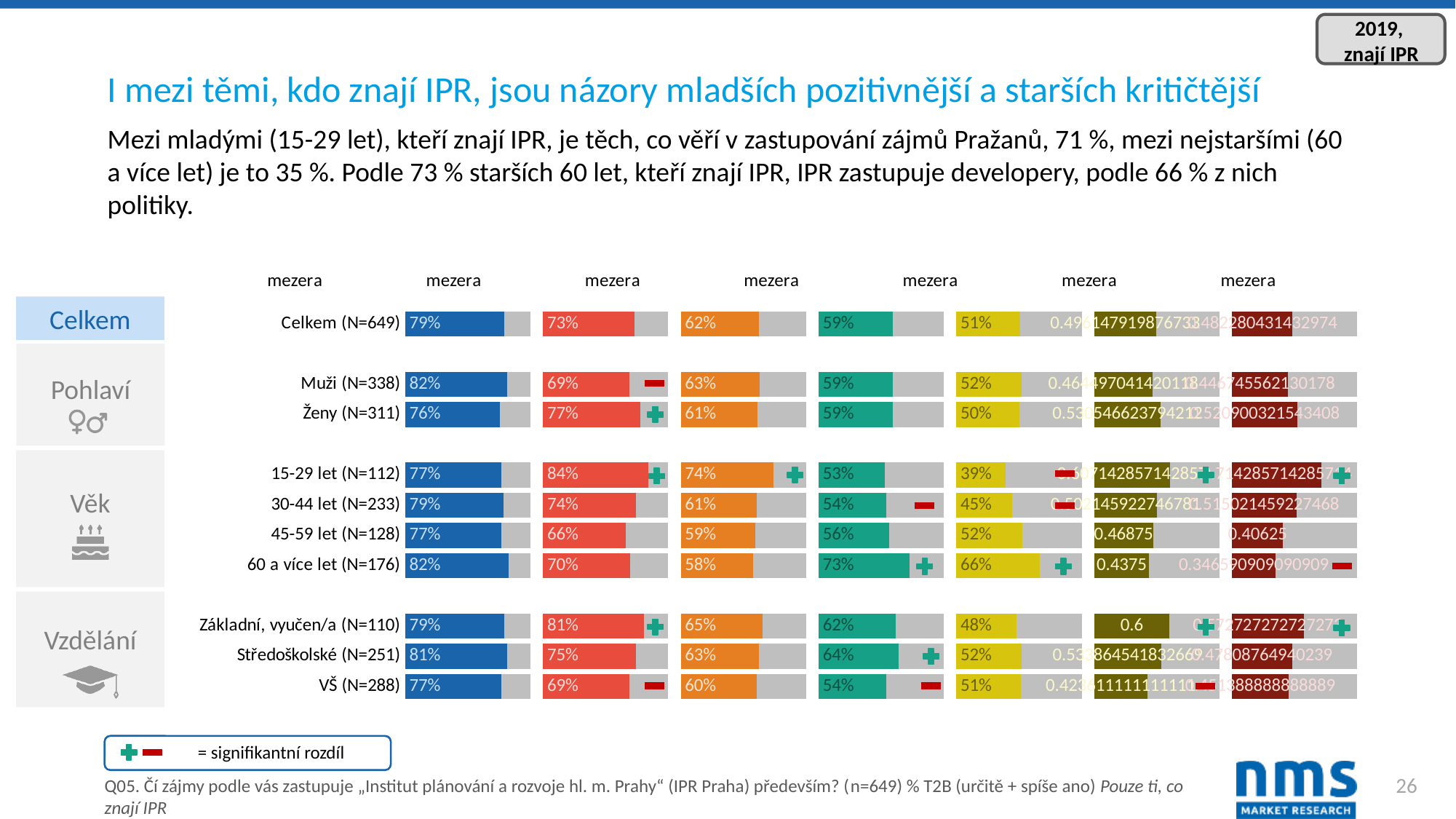
What is the value for 60 a více let (N=176) in the fourth (green) column of bars? 73% What value is printed for 45-59 let (N=128) in the sixth (olive) column of bars? 0.46875 What kind of chart is shown on the slide? Bar chart Among the four age groups, which has the lowest value in the fifth (yellow) column? 15-29 let (N=112) What is the value for VŠ (N=288) in the third (orange) column of bars? 60% Among the four age groups, which has the highest value in the first (blue) column? 60 a více let (N=176) In the second (red) column, which is larger: the value for Muži (N=338) or for Ženy (N=311)? Ženy (N=311) What is the value for 15-29 let (N=112) in the second (red) column of bars? 84% What is the value for Celkem (N=649) in the first (blue) column of bars? 79% In the first (blue) column, what is the difference between the values for Muži (N=338) and Ženy (N=311)? 6 percentage points How many age-group rows (Věk) are shown in the chart? 4 What is the value for 60 a více let (N=176) in the fifth (yellow) column of bars? 66%